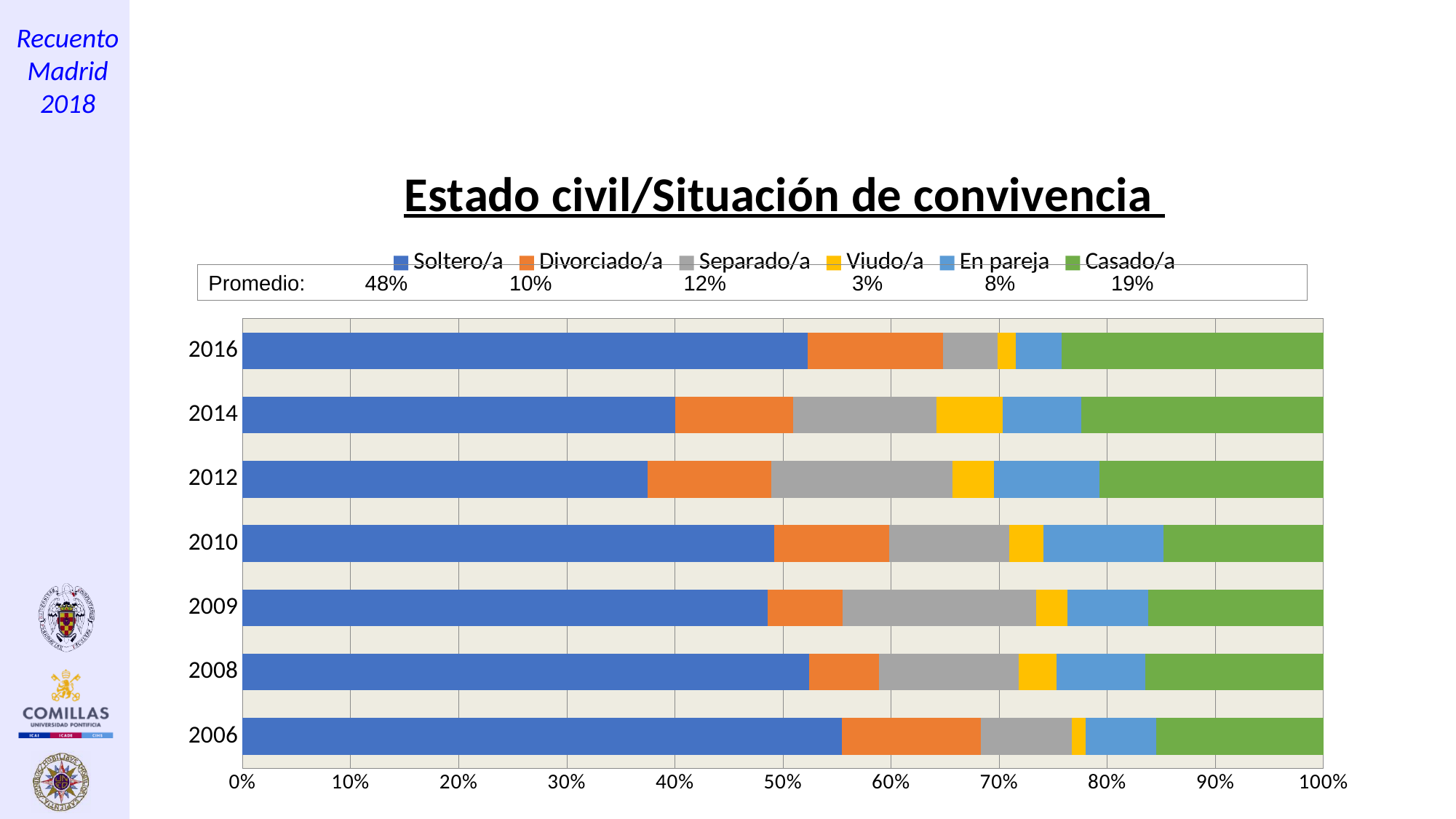
How many years are shown on the vertical axis of the chart? 7 Which year has the largest Soltero/a segment? 2006 Which year has the smallest Soltero/a segment? 2012 Which year has the largest Viudo/a segment? 2014 How many series does the legend list? 6 Is the Soltero/a share for 2006 greater or less than 50%? greater Is the Soltero/a share for 2012 greater or less than 40%? less What kind of chart is shown on the slide? Stacked bar chart What is the Promedio value shown for Soltero/a? 48% What is the Promedio value shown for Casado/a? 19% What is the Promedio value shown for Viudo/a? 3% What is the title of the chart? Estado civil/Situación de convivencia